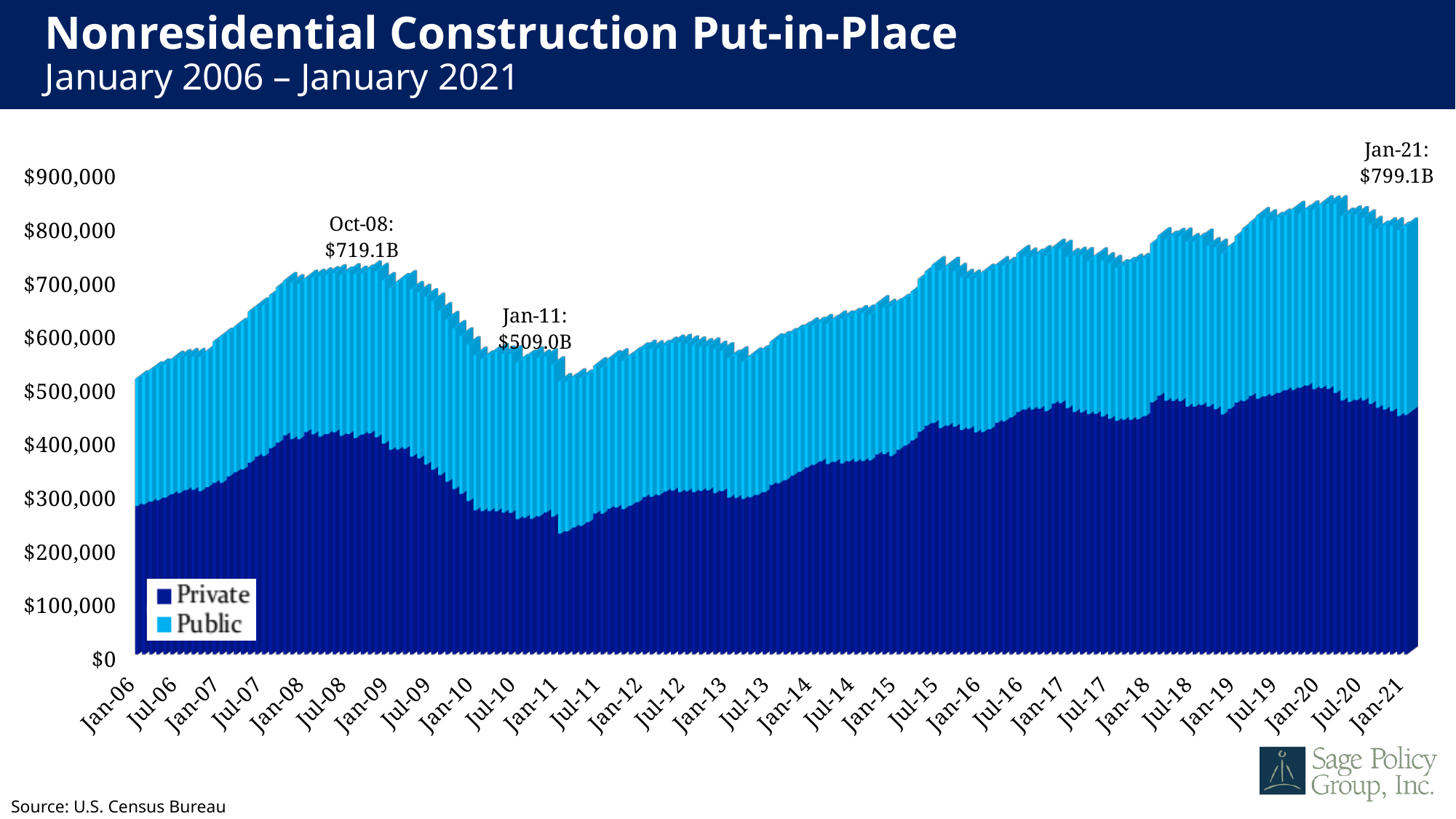
Is the Private value for Jan-11 greater or less than $300,000? less What is the total value labeled for Jan-21? $799.1B Which is larger, the labeled total for Jan-21 or for Oct-08? Jan-21 How much higher is the labeled Jan-21 total than the labeled Jan-11 total? $290.1B How many series does the legend list? 2 Of the three labeled points (Oct-08, Jan-11, Jan-21), which has the lowest total value? Jan-11 Of the three labeled points (Oct-08, Jan-11, Jan-21), which has the highest total value? Jan-21 Is the total value for Jan-06 greater or less than $600,000? less What kind of chart is shown on the slide? Stacked bar chart What is the total value labeled for Jan-11? $509.0B What is the total nonresidential construction put-in-place value labeled for Oct-08? $719.1B What is the difference between the labeled Oct-08 total and the labeled Jan-11 total? $210.1B